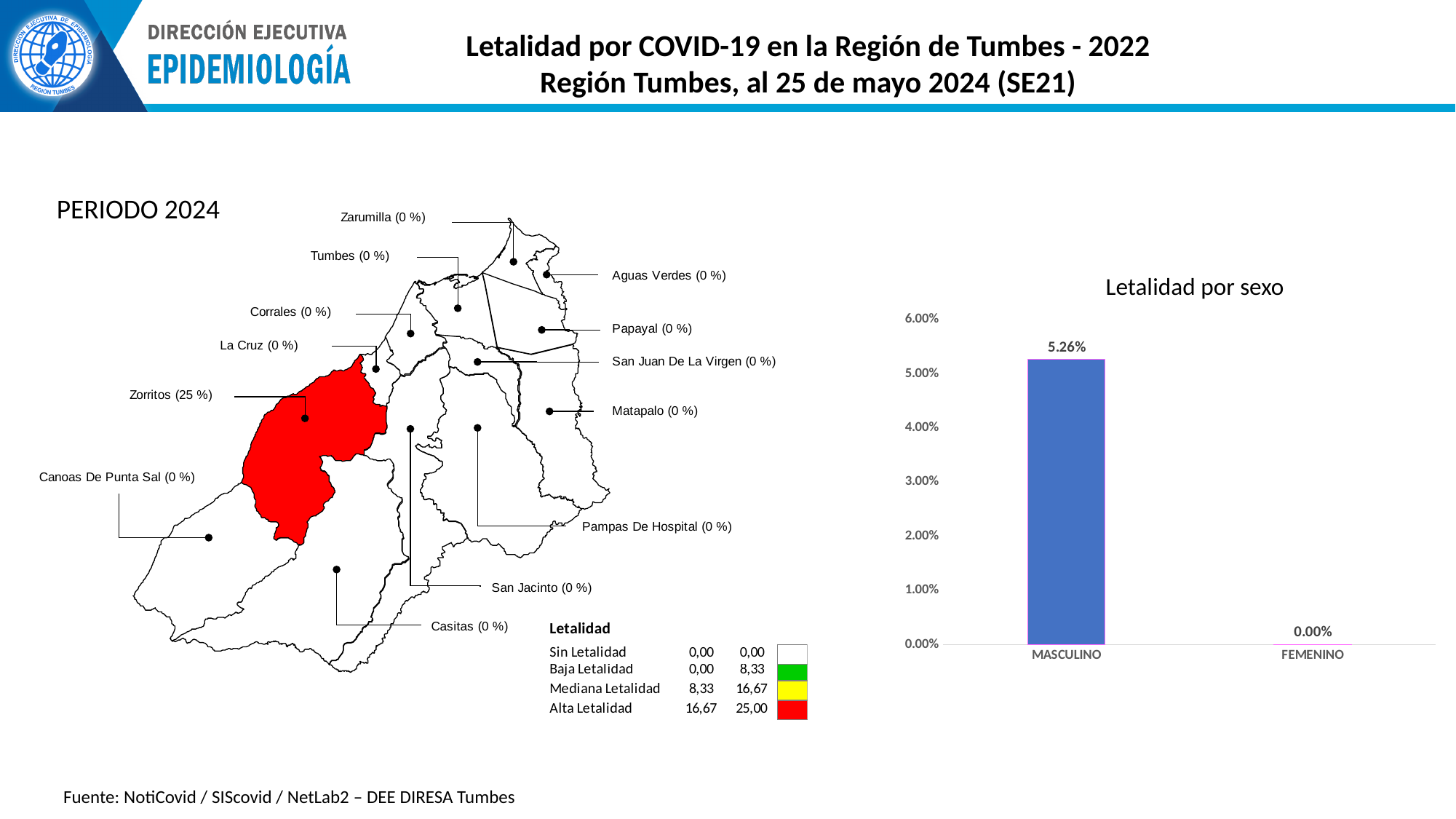
In the 'Letalidad por sexo' chart, what is the value for MASCULINO? 5.26% In the 'Letalidad por sexo' chart, what is the value for FEMENINO? 0.00% In the map legend 'Letalidad', what colour represents 'Alta Letalidad'? red On the map of the Tumbes region, what lethality value is shown for Tumbes? 0 % How many categories are shown on the x axis of the 'Letalidad por sexo' chart? 2 In the 'Letalidad por sexo' chart, which category has the highest value? MASCULINO In the 'Letalidad por sexo' chart, which category has the lowest value? FEMENINO On the map of the Tumbes region, which district is shown with a lethality of 25 %? Zorritos What is the highest value shown on the y axis of the 'Letalidad por sexo' chart? 6.00% What kind of chart is 'Letalidad por sexo'? bar chart In the 'Letalidad por sexo' chart, what is the difference between the MASCULINO and FEMENINO values? 5.26% In the 'Letalidad por sexo' chart, is the value for MASCULINO greater or less than 5.00%? greater